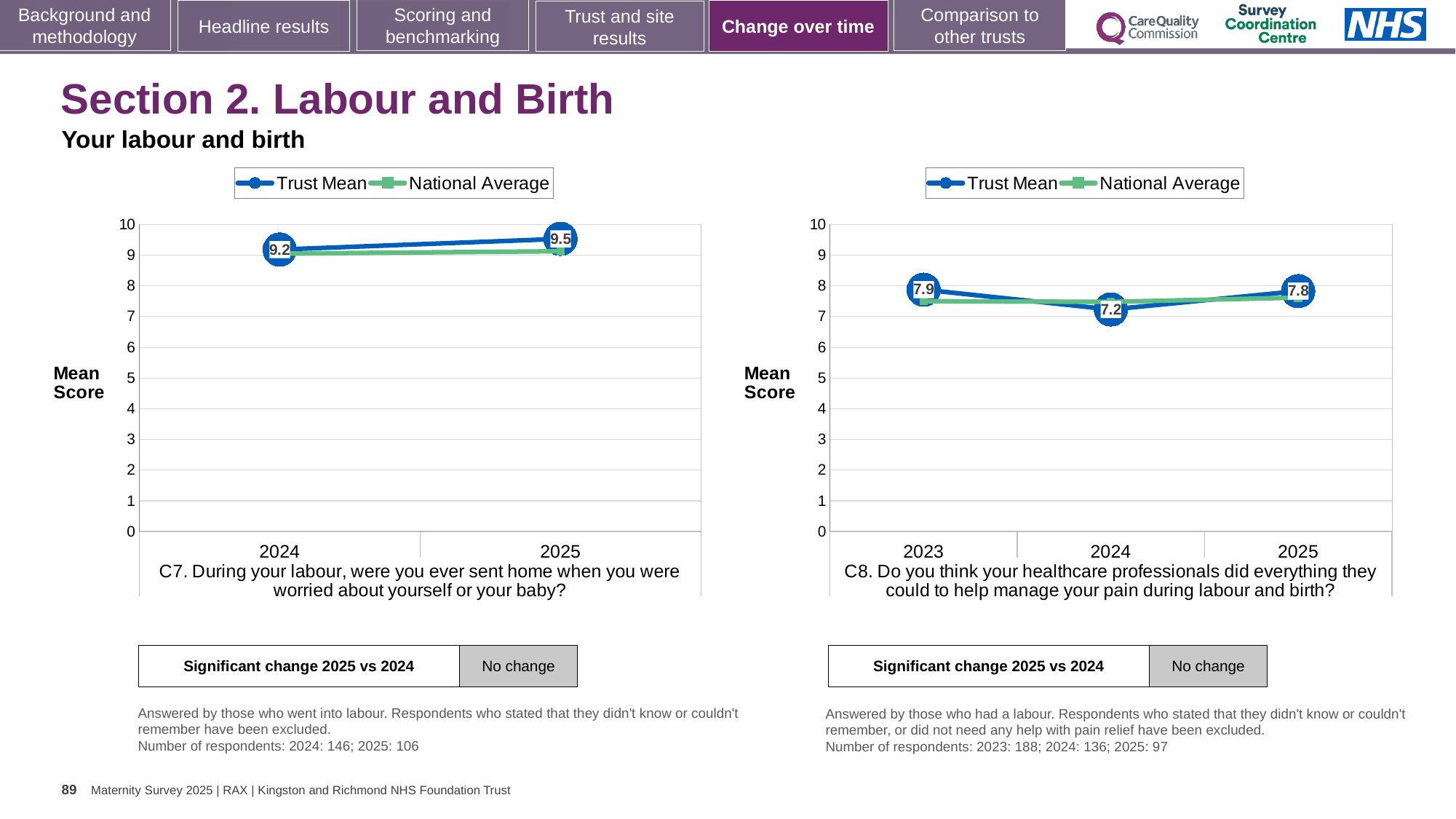
How many years are plotted in the C8 chart on the right? 3 In the C7 chart on the left, does the Trust Mean rise or fall from 2024 to 2025? rise In the C7 chart on the left, what is the Trust Mean for 2025? 9.5 How many series does the legend of the C7 chart on the left list? 2 In the C8 chart on the right, what is the difference between the Trust Mean in 2023 and 2024? 0.7 In the C8 chart on the right, which year has the highest Trust Mean? 2023 In the C8 chart on the right, what is the Trust Mean for 2023? 7.9 What type of chart is the C8 chart on the right? line chart In the C7 chart on the left, what is the Trust Mean for 2024? 9.2 In the C8 chart on the right, what is the Trust Mean for 2024? 7.2 In the C8 chart on the right, which year has the lowest Trust Mean? 2024 In the C7 chart on the left, by how much did the Trust Mean change from 2024 to 2025? 0.3